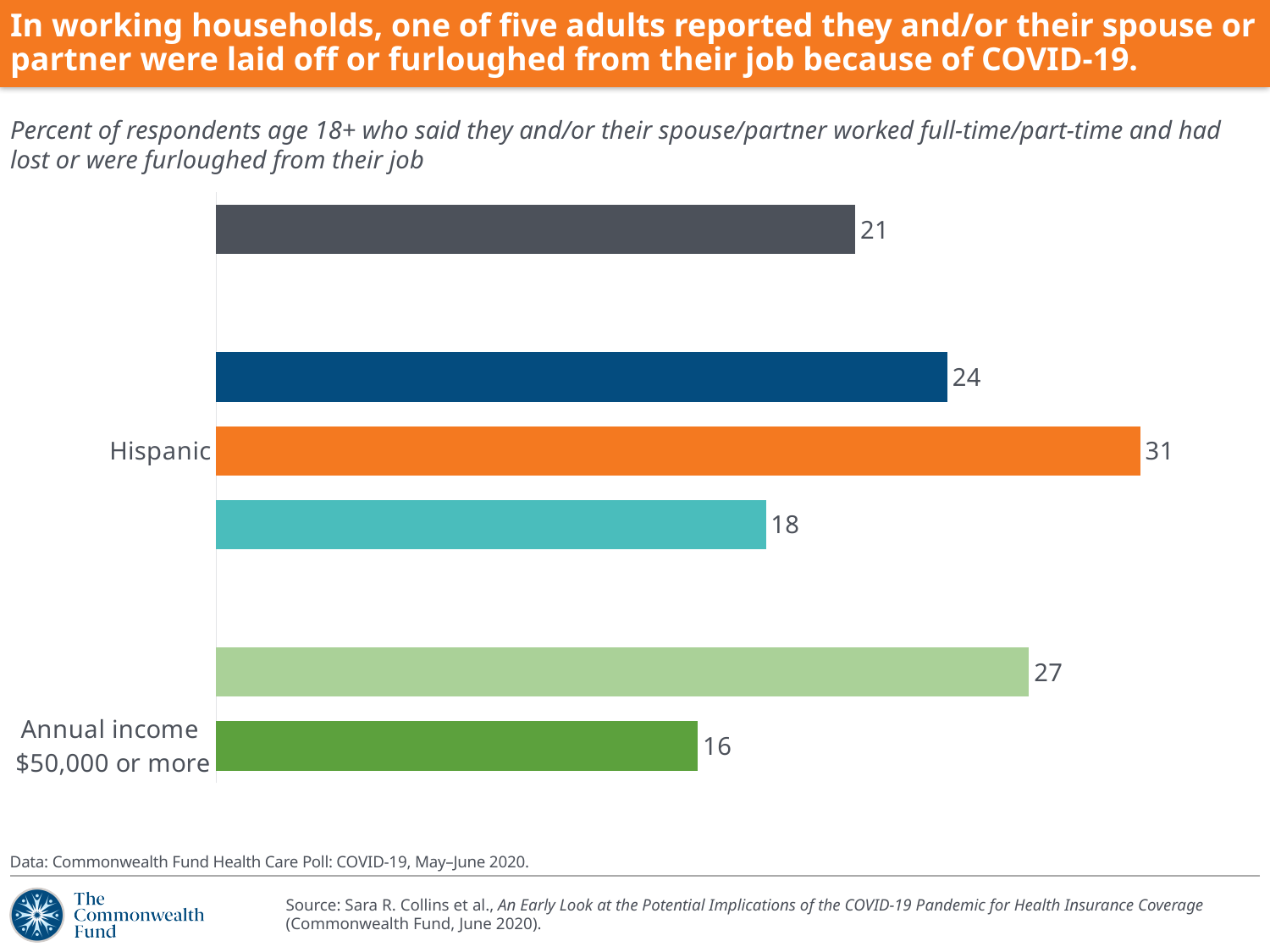
What is the value for Annual income $50,000 or more? 16 Which labeled category has the lowest value in the chart? Annual income $50,000 or more What colour is the bar for Hispanic? Orange Which labeled category has the highest value in the chart? Hispanic What is the difference between the value for Hispanic and the value for Annual income $50,000 or more? 15 What kind of chart is shown on the slide? Bar chart What is the value for Hispanic? 31 What is the lowest value shown in the chart? 16 How many bars are plotted in the chart? 6 Which is larger, the value for Hispanic or the value for Annual income $50,000 or more? Hispanic What is the highest value shown in the chart? 31 How many bars in the chart have a value above 20? 4